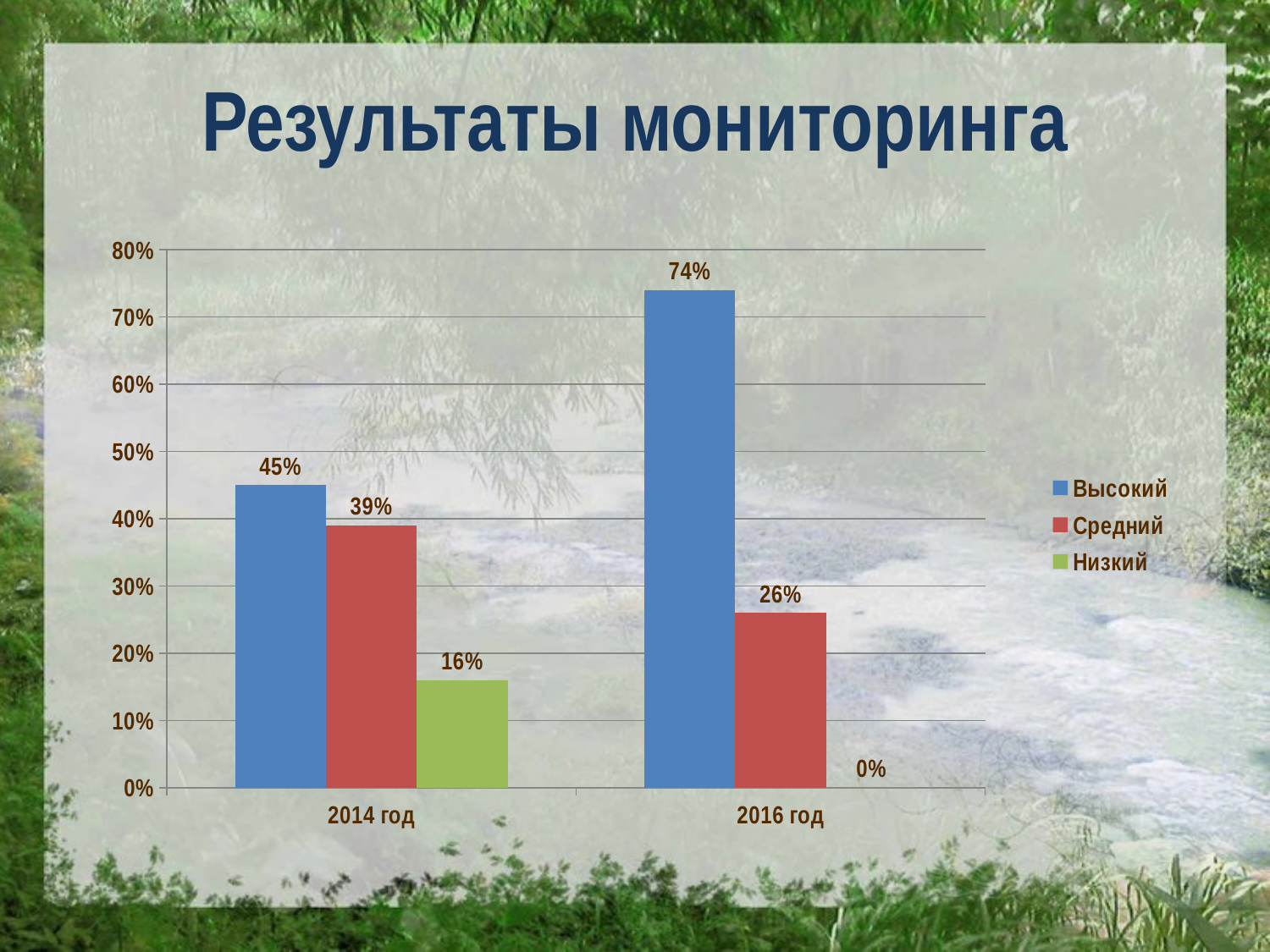
What is the title of the slide? Результаты мониторинга What is the value for Низкий in 2016 год? 0% Which series has the highest value in 2016 год? Высокий Which is larger: Средний in 2014 год or Средний in 2016 год? Средний in 2014 год How many categories are shown on the x axis? 2 How many series does the legend list? 3 What is the difference between the Высокий values for 2016 год and 2014 год? 29% What is the value for Средний in 2016 год? 26% What kind of chart is shown on the slide? Bar chart What is the value for Низкий in 2014 год? 16% What is the value for Высокий in 2014 год? 45% Which series has the lowest value in 2014 год? Низкий